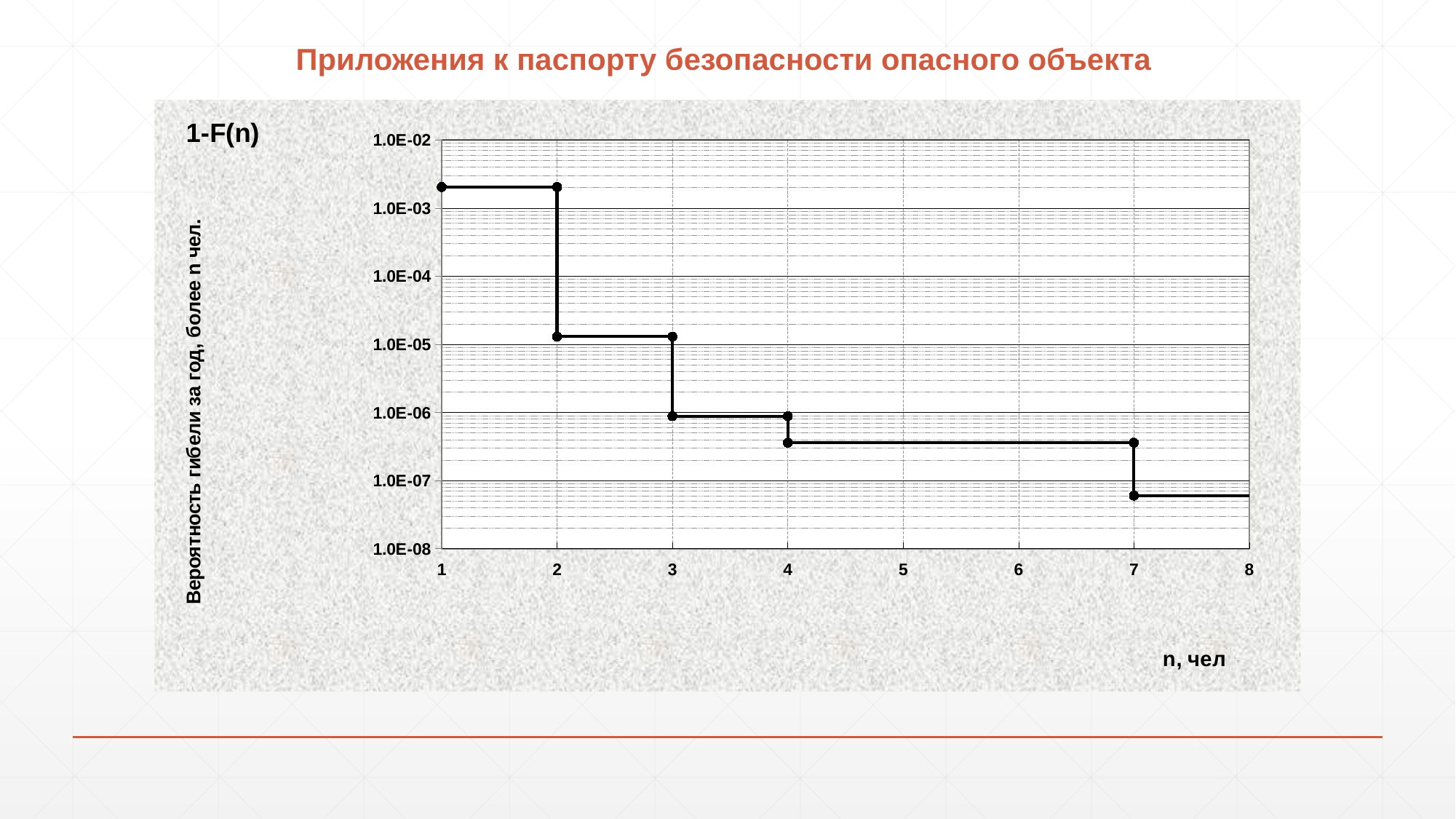
What kind of chart is shown on the slide? line chart What is the lowest value labelled on the y axis? 1.0E-08 How many tick values are labelled on the x axis? 8 Do the plotted values rise or fall as n increases along the x axis? fall Is the value of 1-F(n) at n = 6 greater or less than 1.0E-07? greater Is the value of 1-F(n) at n = 1 greater or less than 1.0E-02? less Is the value of 1-F(n) at n = 8 greater or less than 1.0E-07? less What is the label of the x axis? n, чел Which is larger, the value of 1-F(n) at n = 1 or at n = 8? n = 1 At which value of n is 1-F(n) highest? 1